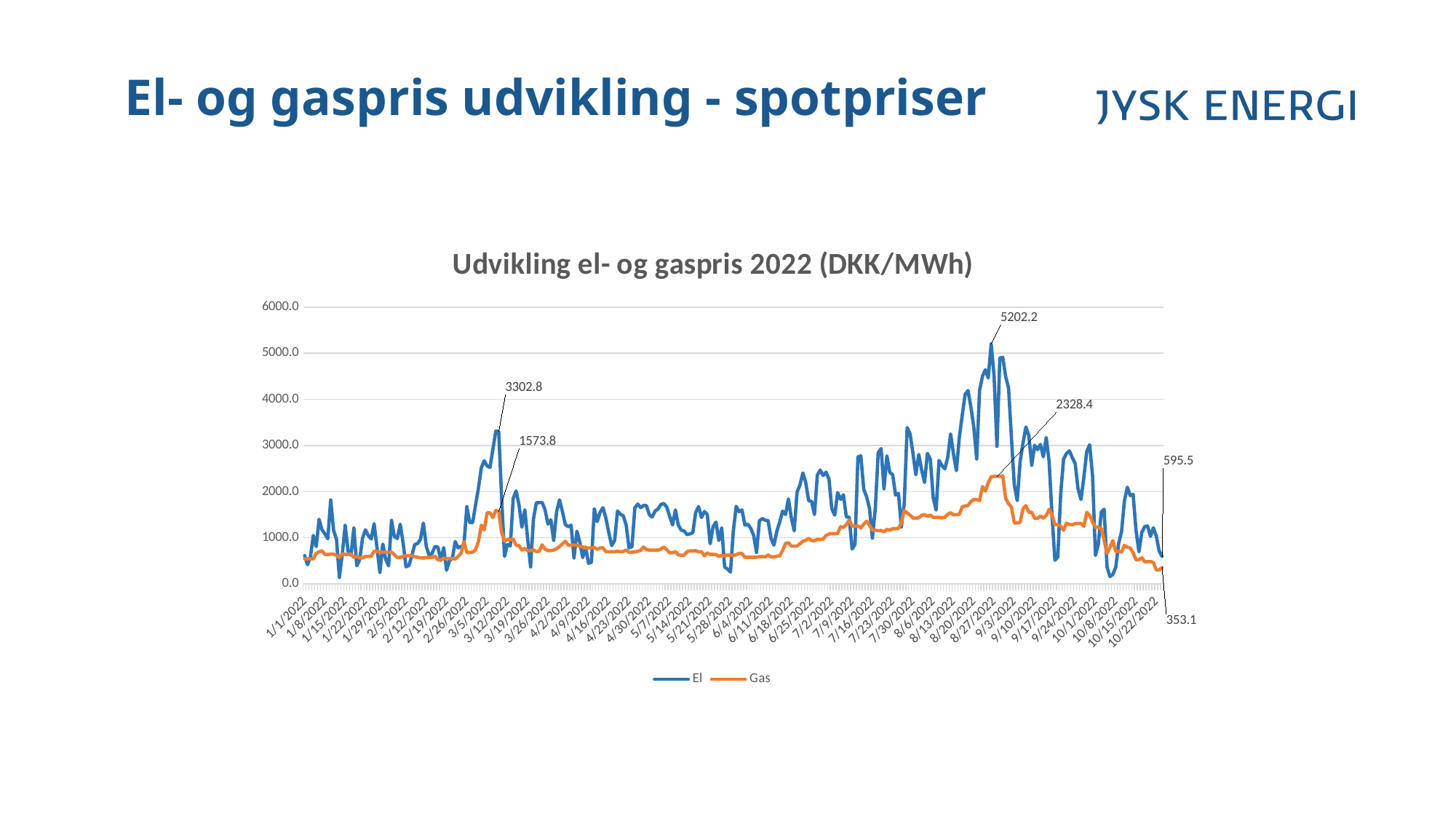
How many series does the legend list? 2 What are the two series named in the legend? El and Gas Is the Gas value around 6/4/2022 greater or less than 1000? less What is the highest labelled value of the Gas series? 2328.4 What is the labelled value of the El series at the end of the chart (late October 2022)? 595.5 What is the labelled value of the Gas series at the end of the chart (late October 2022)? 353.1 What is the difference between the final labelled El value (595.5) and the final labelled Gas value (353.1)? 242.4 What is the difference between the labelled El peak of 5202.2 and the labelled Gas peak of 2328.4? 2873.8 What is the highest labelled value of the El series? 5202.2 Which series reaches the higher peak value, El or Gas? El What is the title of the chart? Udvikling el- og gaspris 2022 (DKK/MWh) What kind of chart is shown on the slide? line chart